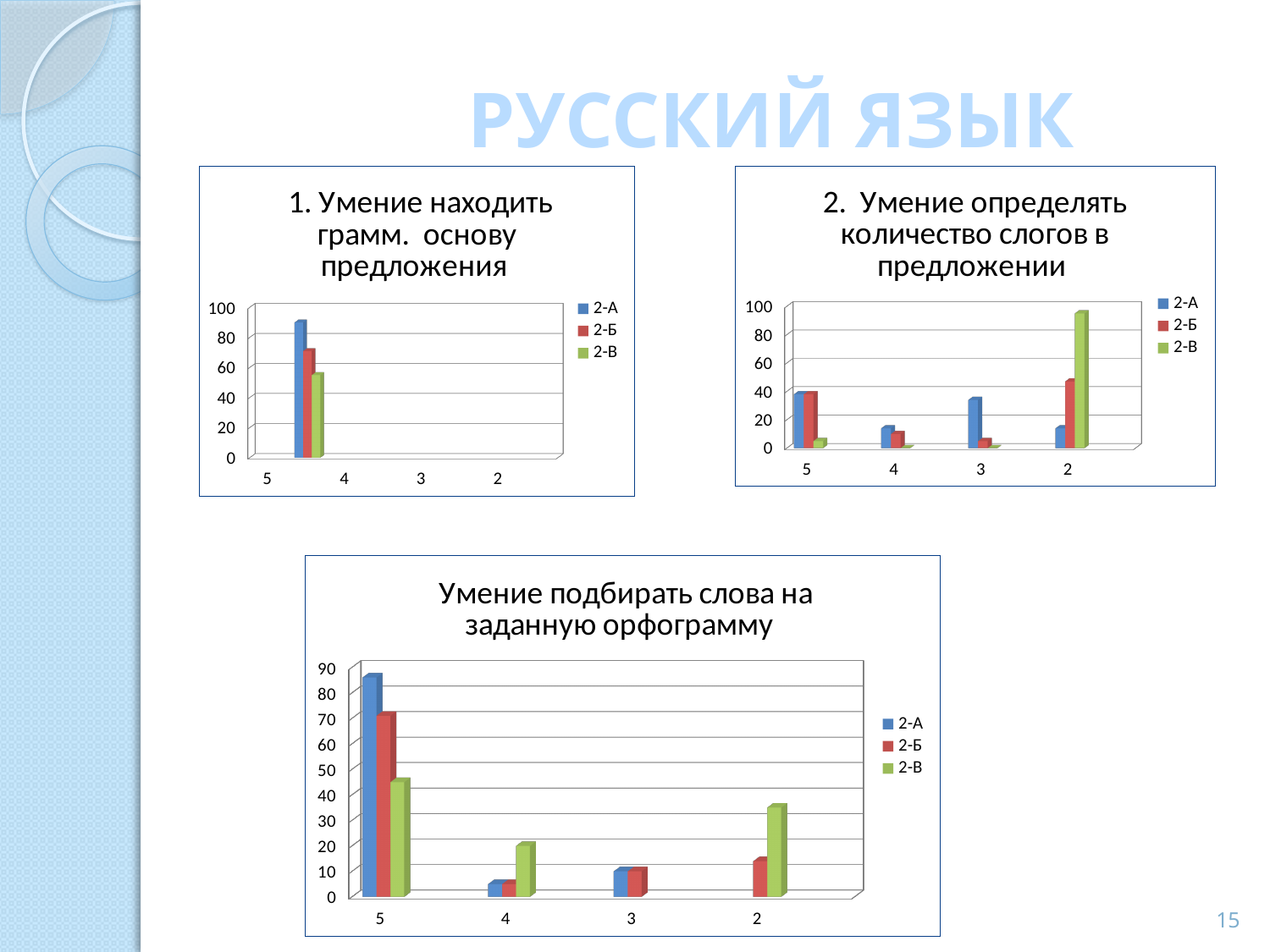
In the chart titled "1. Умение находить грамм. основу предложения", how many series does the legend list? 3 In the chart titled "Умение подбирать слова на заданную орфограмму", which series has the lowest value for category 5? 2-В In the chart titled "2. Умение определять количество слогов в предложении", which series has the highest value for category 2? 2-В In the chart titled "2. Умение определять количество слогов в предложении", is the value of 2-В for category 2 greater or less than 80? greater In the chart titled "1. Умение находить грамм. основу предложения", which series has the highest value for category 5? 2-А What kind of chart is the one titled "Умение подбирать слова на заданную орфограмму"? bar chart In the chart titled "Умение подбирать слова на заданную орфограмму", what is the highest value shown on the vertical axis? 90 In the chart titled "Умение подбирать слова на заданную орфограмму", which is larger for category 2: 2-Б or 2-В? 2-В In the chart titled "1. Умение находить грамм. основу предложения", is the value of 2-А for category 5 greater or less than 80? greater In the chart titled "2. Умение определять количество слогов в предложении", which is larger for category 3: 2-А or 2-Б? 2-А In the chart titled "2. Умение определять количество слогов в предложении", how many categories are shown on the x axis? 4 In the chart titled "Умение подбирать слова на заданную орфограмму", is the value of 2-А for category 5 greater or less than 80? greater